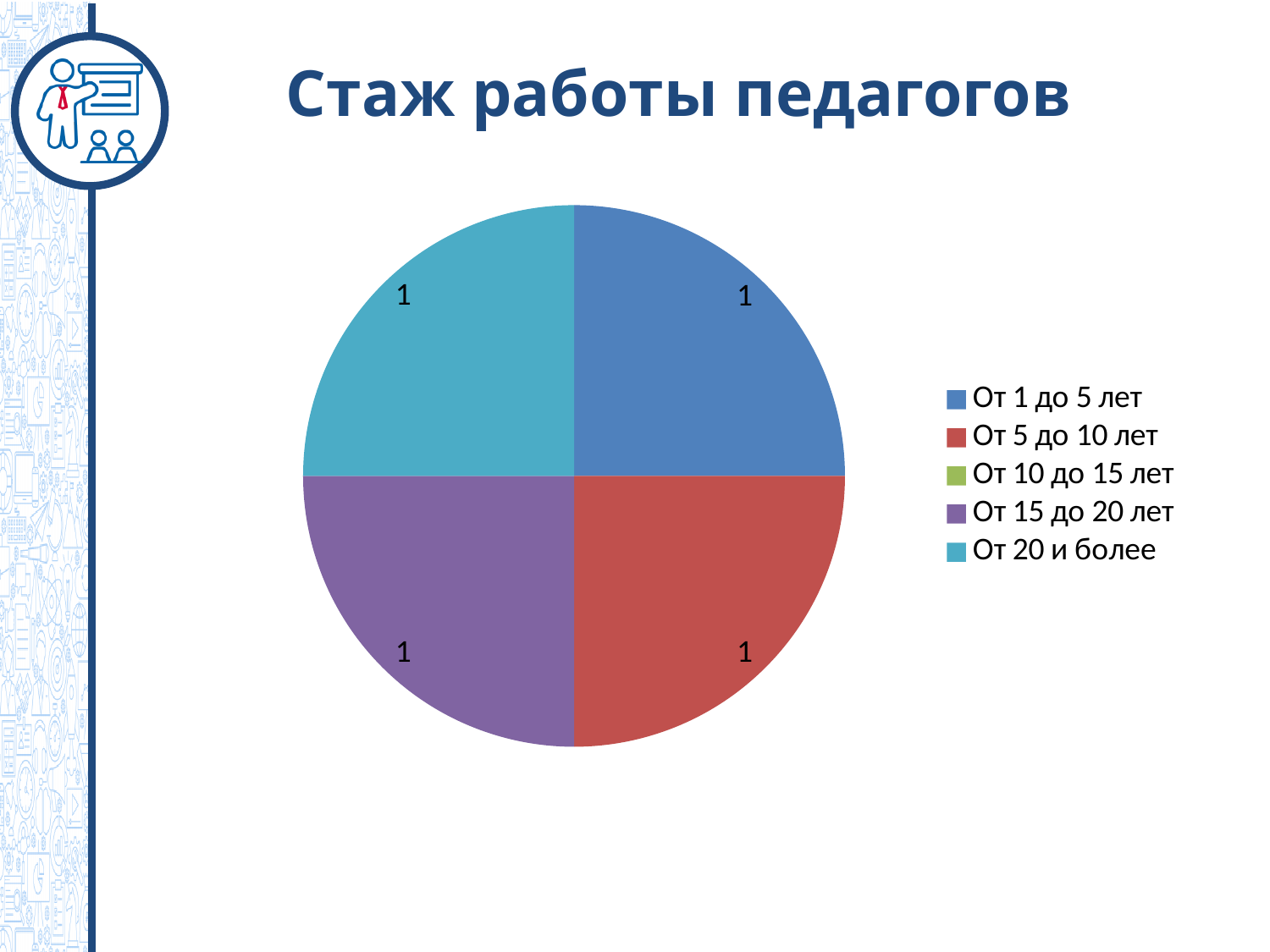
What is the value shown for the slice "От 20 и более"? 1 How many slices are visible in the pie chart? 4 Which legend entry has no visible slice in the pie chart? От 10 до 15 лет What is the value shown for the slice "От 1 до 5 лет"? 1 How many entries does the chart legend list? 5 What is the value shown for the slice "От 15 до 20 лет"? 1 What kind of chart is shown on the slide? pie chart What is the value shown for the slice "От 5 до 10 лет"? 1 What is the total of the values printed on the pie slices? 4 What is the title of the chart? Стаж работы педагогов What is the difference between the values for "От 1 до 5 лет" and "От 20 и более"? 0 What share of the pie does the slice "От 5 до 10 лет" represent? 25%